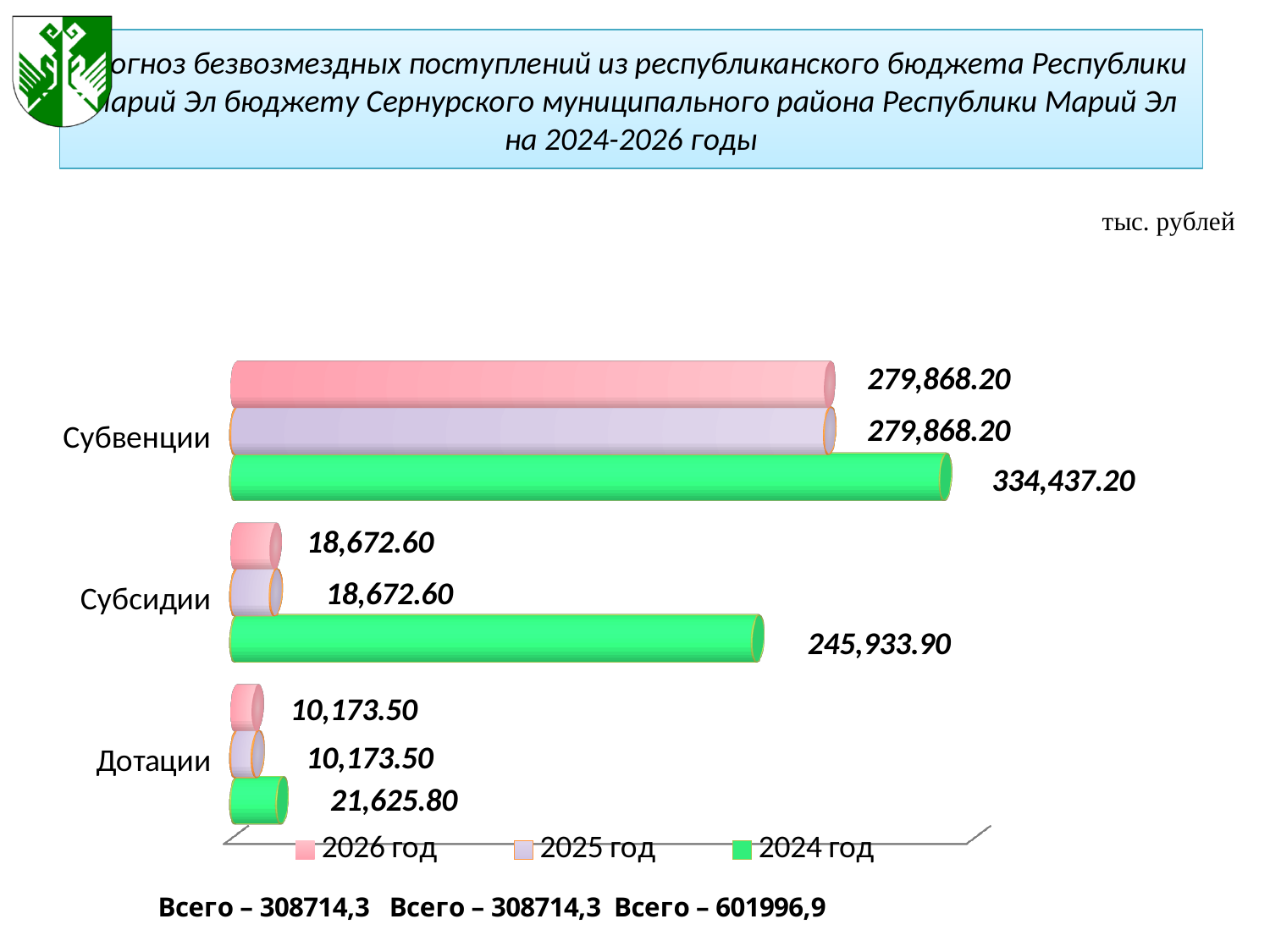
What kind of chart is shown on the slide? Bar chart What is the value for Субсидии in the 2024 год series? 245,933.90 Which category has the highest value in the 2024 год series? Субвенции What is the value for Субвенции in the 2024 год series? 334,437.20 How many categories are shown on the chart? 3 What is the difference between the 2024 год and 2026 год values for Субсидии? 227,261.30 What is the value for Дотации in the 2026 год series? 10,173.50 Which is larger: the 2024 год value for Субсидии or the 2025 год value for Субвенции? 2025 год value for Субвенции Which category has the lowest value in the 2026 год series? Дотации What is the value for Субсидии in the 2025 год series? 18,672.60 What is the difference between the 2024 год and 2025 год values for Субвенции? 54,569.00 How many series does the legend list? 3